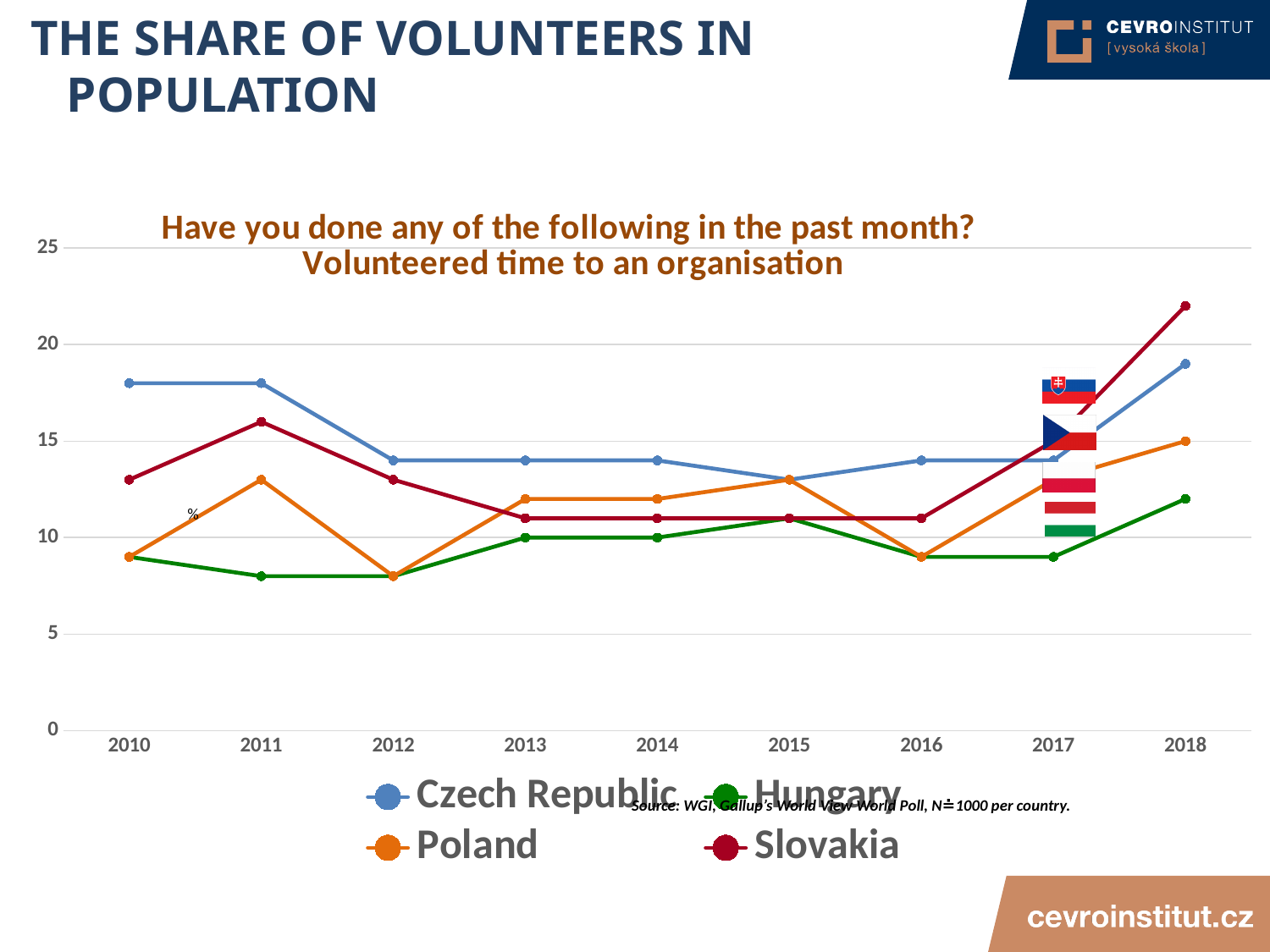
Which country has the highest value in 2018? Slovakia Does the value for Slovakia rise or fall from 2016 to 2018? rise What kind of chart is shown on the slide? line chart Is the value for Slovakia in 2018 greater or less than 20? greater Is the value for Hungary in 2011 greater or less than 10? less What is the value for Poland in 2018? 15 Which country has the lowest value in 2011? Hungary How many series does the legend list? 4 In 2011, which is higher: Czech Republic or Slovakia? Czech Republic How many years are shown on the x axis? 9 Which country has the lowest value in 2018? Hungary Which country has the highest value in 2010? Czech Republic